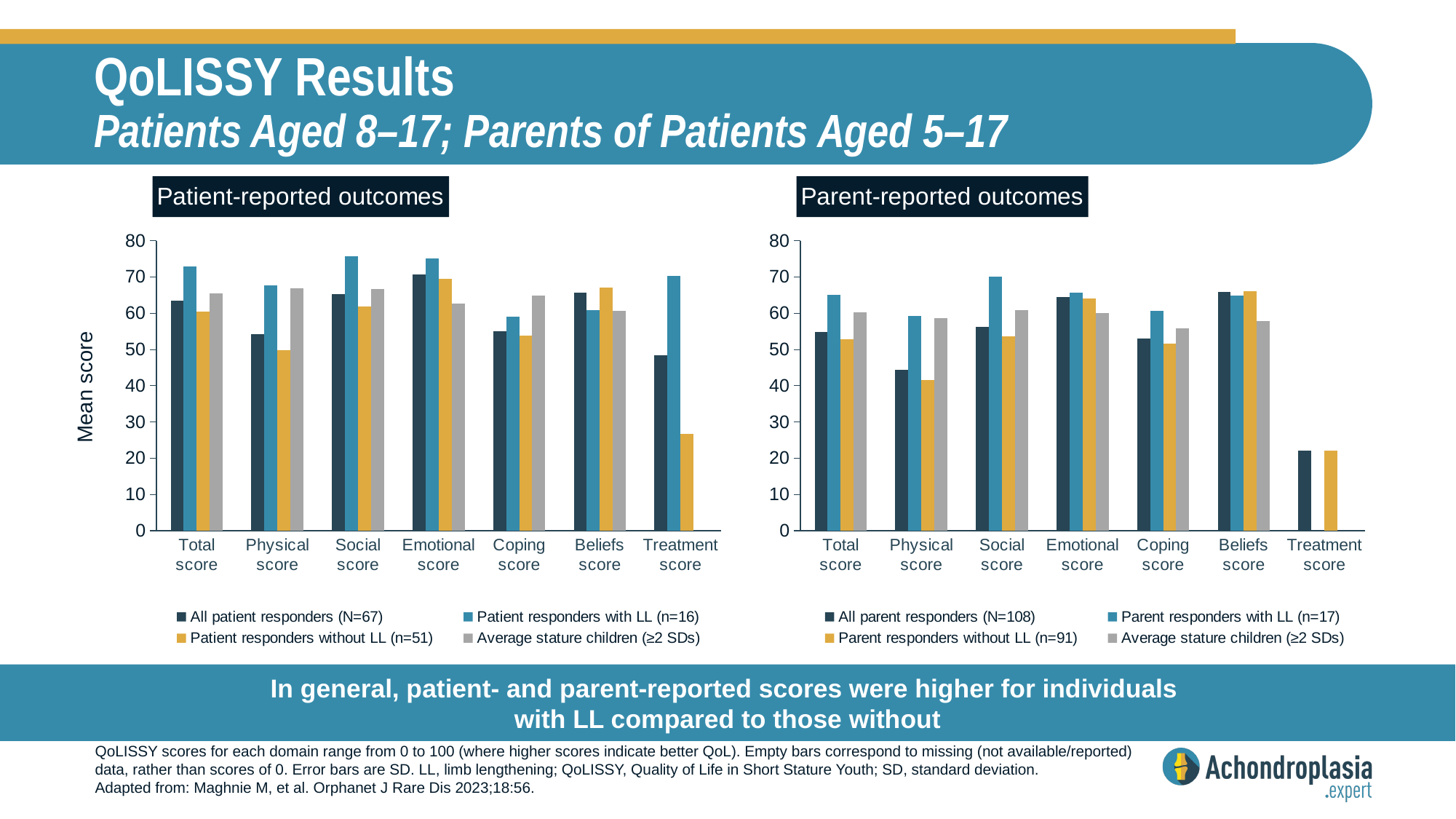
In the Parent-reported outcomes chart, which category has the lowest bar for All parent responders (N=108)? Treatment score In the Patient-reported outcomes chart, which category has the lowest bar for Patient responders without LL (n=51)? Treatment score In the Patient-reported outcomes chart, is the Treatment score for Patient responders with LL (n=16) greater or less than 60? greater In the Patient-reported outcomes chart, is the Social score for Patient responders with LL (n=16) greater or less than 70? greater In the Patient-reported outcomes chart, is the Treatment score for Patient responders without LL (n=51) greater or less than 30? less What is the y-axis label of the Patient-reported outcomes chart? Mean score How many score categories are shown on the x axis of the Parent-reported outcomes chart? 7 In the Parent-reported outcomes chart, for the Physical score, which is larger: Parent responders with LL (n=17) or Parent responders without LL (n=91)? Parent responders with LL (n=17) How many series does the legend of the Patient-reported outcomes chart list? 4 What kind of chart is the Patient-reported outcomes chart? bar chart